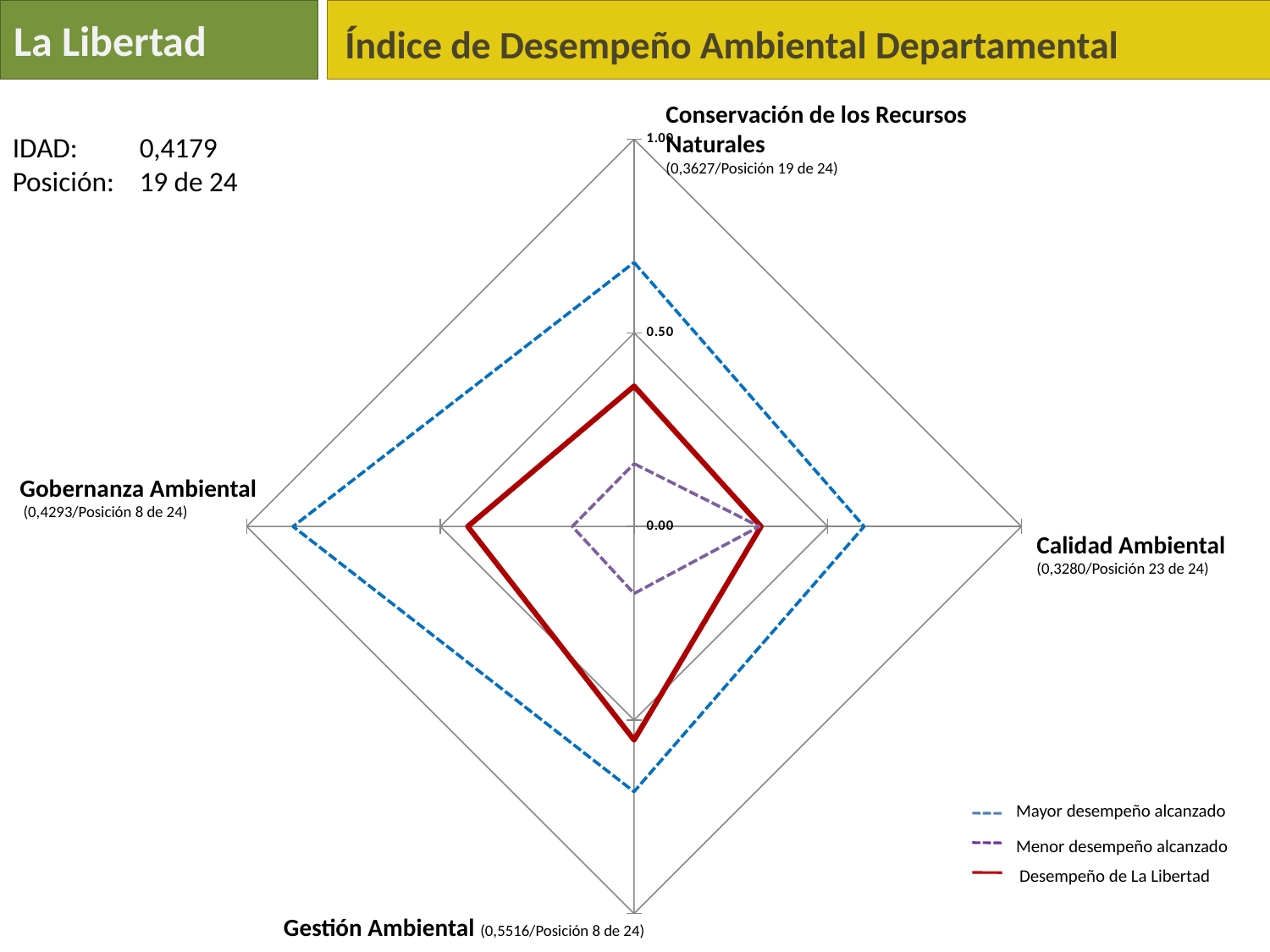
What is the difference between La Libertad's values for Gestión Ambiental and Calidad Ambiental? 0,2236 What type of chart is shown on the slide? radar chart Is the 'Mayor desempeño alcanzado' value for Gestión Ambiental greater or less than 0.50? greater What is La Libertad's value for Calidad Ambiental? 0,3280 What is La Libertad's value for Gobernanza Ambiental? 0,4293 What is La Libertad's value for Conservación de los Recursos Naturales? 0,3627 In which dimension does La Libertad have its lowest value? Calidad Ambiental How many dimensions (axes) does the radar chart have? 4 In which dimension does La Libertad have its highest value? Gestión Ambiental How many series does the legend list? 3 What is La Libertad's value for Gestión Ambiental? 0,5516 Which is larger for La Libertad: Gobernanza Ambiental or Conservación de los Recursos Naturales? Gobernanza Ambiental